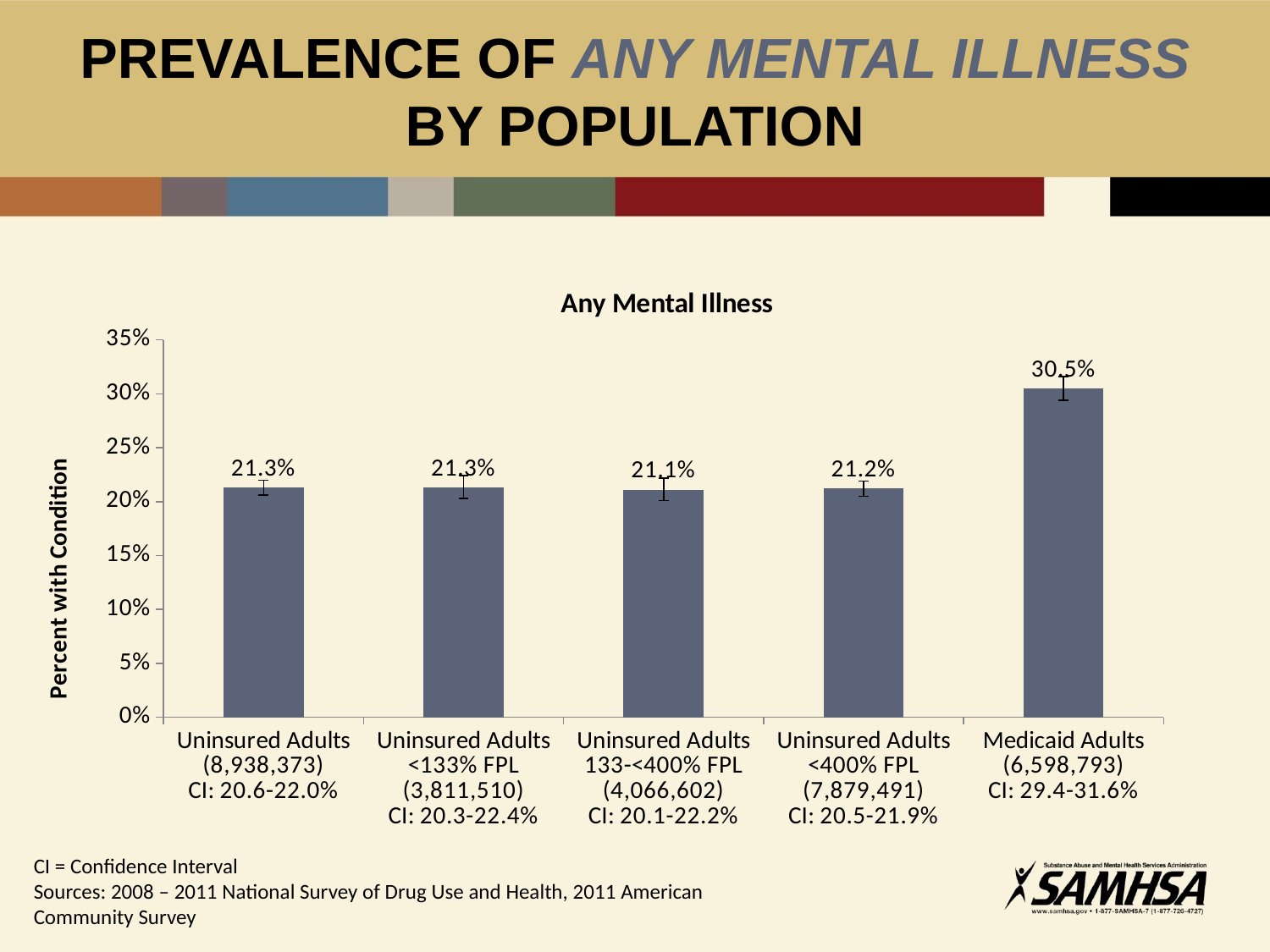
What is the title of the chart? Any Mental Illness What kind of chart is this? bar chart Which is larger, the value for Medicaid Adults or the value for Uninsured Adults <400% FPL? Medicaid Adults What is the value for Uninsured Adults <400% FPL? 21.2% What is the value for Uninsured Adults 133-<400% FPL? 21.1% How many categories are shown on the x axis? 5 What is the label of the y axis? Percent with Condition What is the value for Uninsured Adults <133% FPL? 21.3% What is the value for Medicaid Adults? 30.5% What is the difference between the values for Medicaid Adults and Uninsured Adults (8,938,373)? 9.2% Is the value for Medicaid Adults greater or less than 25%? greater Which category has the highest value? Medicaid Adults